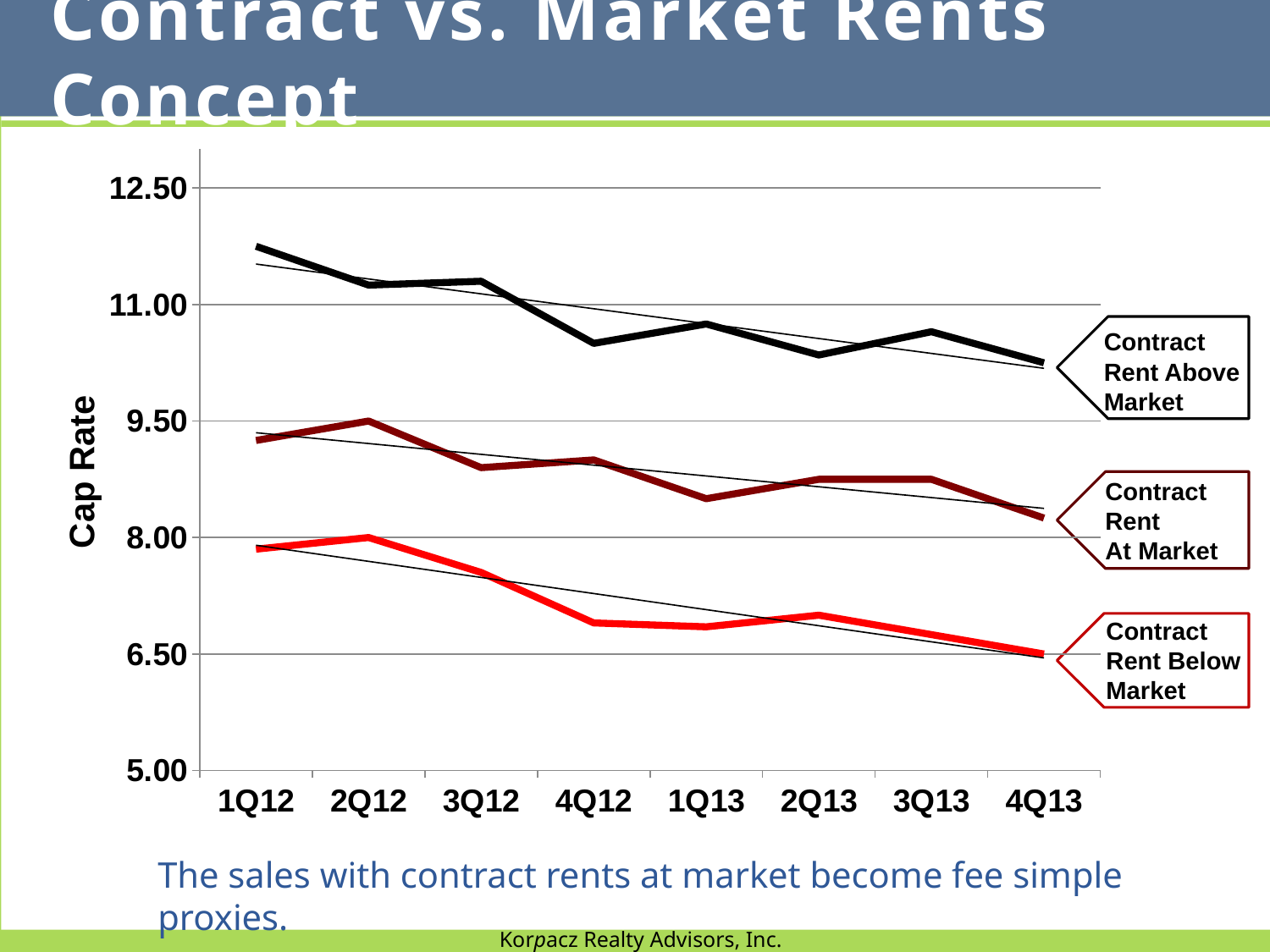
In which quarter is the Contract Rent At Market series at its highest? 2Q12 Is the value for Contract Rent Above Market in 1Q12 greater or less than 11.00? greater Which series is drawn in red? Contract Rent Below Market Is the value for Contract Rent Above Market in 4Q13 greater or less than 11.00? less Is the value for Contract Rent Below Market in 4Q12 greater or less than 6.50? greater Do the cap rates for Contract Rent Below Market generally rise or fall from 1Q12 to 4Q13? fall In which quarter is the Contract Rent Above Market series at its highest? 1Q12 How many data series are labelled on the chart? 3 What is the title of the vertical axis? Cap Rate What kind of chart is shown on the slide? line chart How many quarters are plotted along the x axis? 8